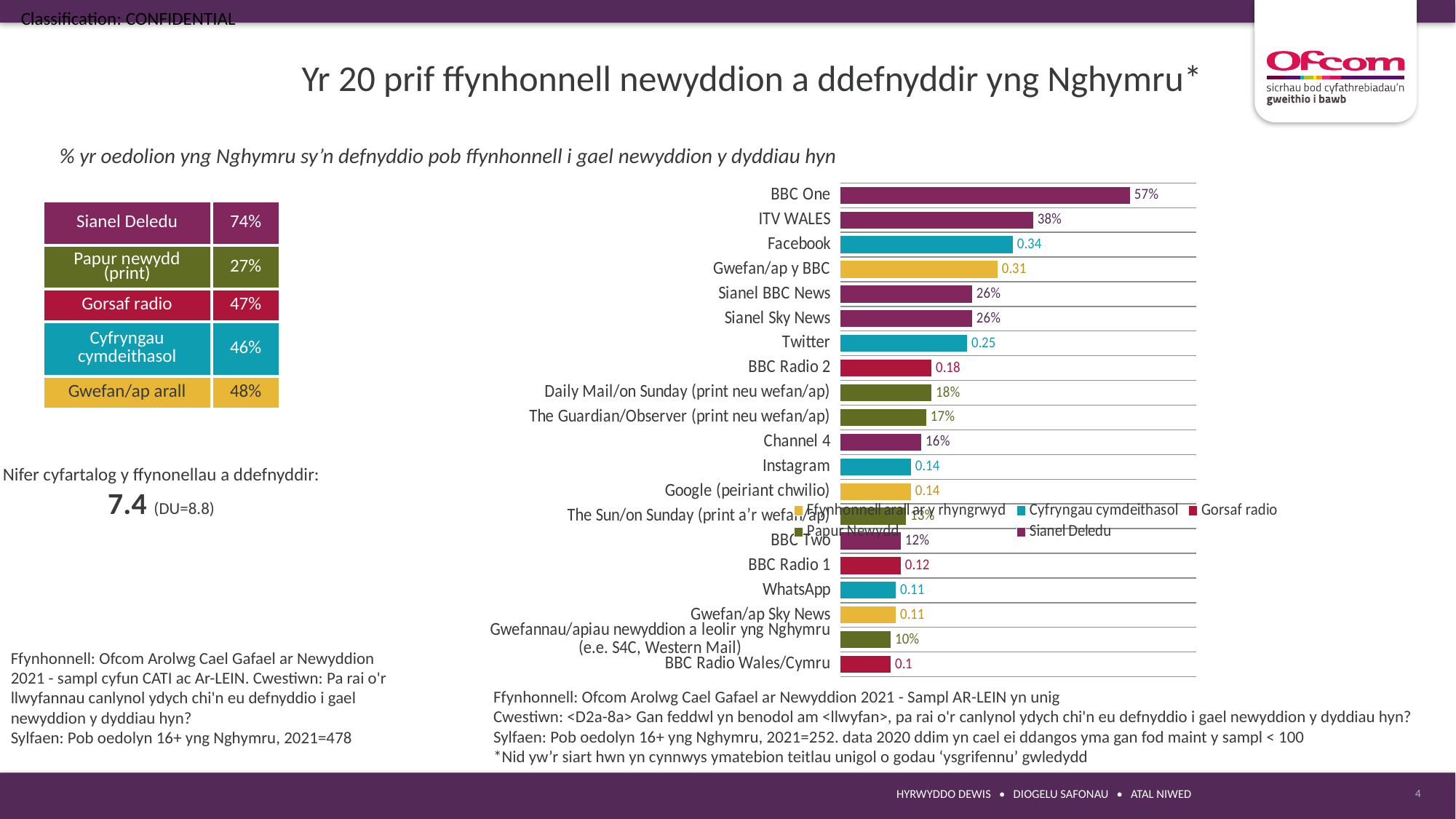
What kind of chart is shown on the slide? Bar chart What is the difference between the values for BBC One and ITV WALES? 19% How many series does the chart legend list? 5 How many categories are plotted in the bar chart? 20 What is the value for Channel 4? 16% Which category has the highest value in the chart? BBC One What is the value shown for BBC Radio Wales/Cymru? 0.1 What is the value shown for Facebook? 0.34 What is the value shown for Twitter? 0.25 What is the value for BBC One? 57% Which is larger, the value for Daily Mail/on Sunday (print neu wefan/ap) or the value for Channel 4? Daily Mail/on Sunday (print neu wefan/ap) What is the value for ITV WALES? 38%